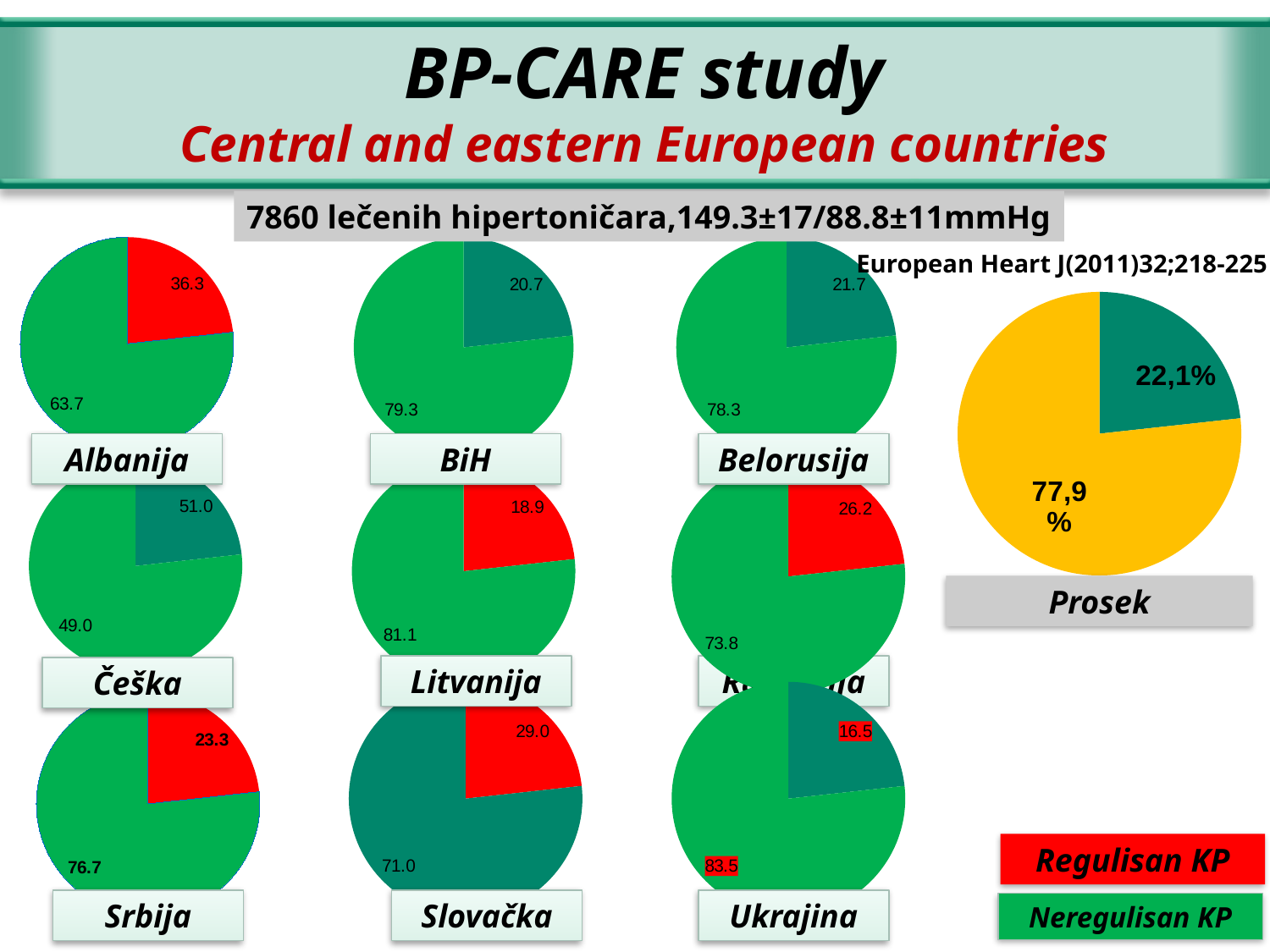
What is the difference between the two slice values in the Srbija pie chart (76.7 and 23.3)? 53.4 What is the label of the red legend entry at the bottom right of the slide? Regulisan KP What is the difference between the two slice values in the Slovačka pie chart (71.0 and 29.0)? 42.0 In the Belorusija pie chart, what value is shown for the smaller slice? 21.7 How many entries does the legend at the bottom right of the slide list? 2 In the Ukrajina pie chart, what value is shown for the larger slice? 83.5 In the Prosek pie chart, what value is shown for the dark green slice? 22,1% In the Albanija pie chart, what value is shown for the smaller (red) slice? 36.3 In the BiH pie chart, what value is shown for the larger (green) slice? 79.3 What kind of charts are shown on the slide? Pie charts In the Prosek pie chart, what value is shown for the yellow slice? 77,9%